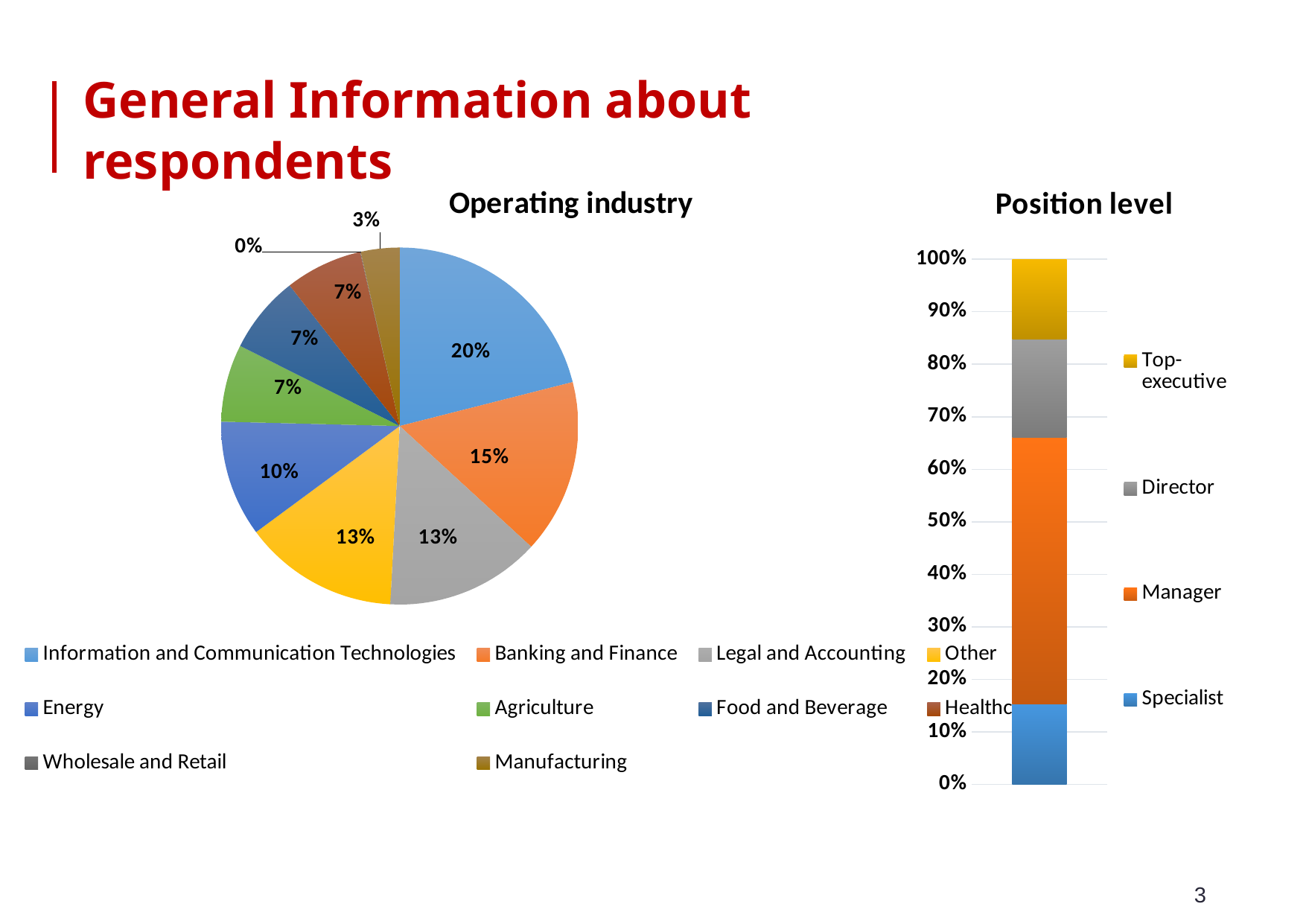
In the Operating industry pie chart, how many percentage points larger is the Information and Communication Technologies share than the Banking and Finance share? 5% How many series does the legend of the Position level chart list? 4 In the Position level chart, is the top of the Specialist segment greater or less than 20%? less In the Position level chart, which series is at the top of the stacked bar? Top-executive In the Operating industry pie chart, what share of respondents are from Manufacturing? 3% How many industry categories are listed in the legend of the Operating industry chart? 10 What kind of chart is the Operating industry chart? Pie chart In the Operating industry pie chart, what share of respondents are from Information and Communication Technologies? 20% In the Operating industry pie chart, what share of respondents are from Banking and Finance? 15% In the Operating industry pie chart, which industry has the smallest share? Wholesale and Retail In the Operating industry pie chart, which has a larger share, Energy or Agriculture? Energy In the Operating industry pie chart, which industry has the largest share? Information and Communication Technologies